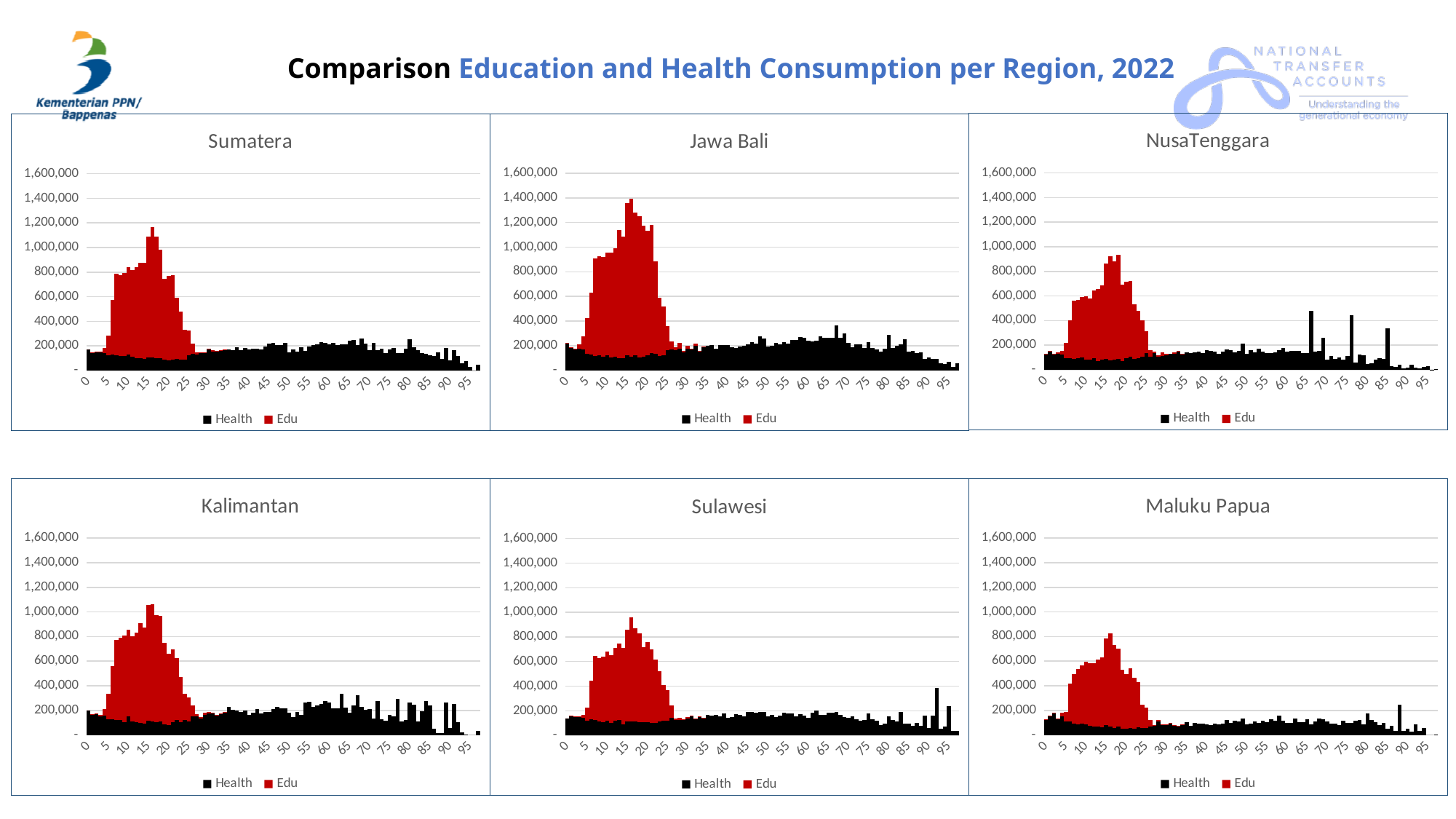
What colour represents Edu in the Sulawesi chart? red In the Sumatera chart, does the Edu value rise or fall between age 25 and age 30? fall Which chart shows a higher peak Edu value, Sumatera or NusaTenggara? Sumatera In the Maluku Papua chart, is the peak Edu value greater or less than 1,000,000? less In the Kalimantan chart, is the Edu value at age 15 greater or less than 800,000? greater In the Jawa Bali chart, is the peak Edu value greater or less than 1,200,000? greater How many series does the legend of the Jawa Bali chart list? 2 Which chart shows a higher peak Edu value, Jawa Bali or Sulawesi? Jawa Bali Which two series are listed in the legend of the Kalimantan chart? Health and Edu What kind of chart is the Sumatera chart? bar chart How many charts are shown on the slide? 6